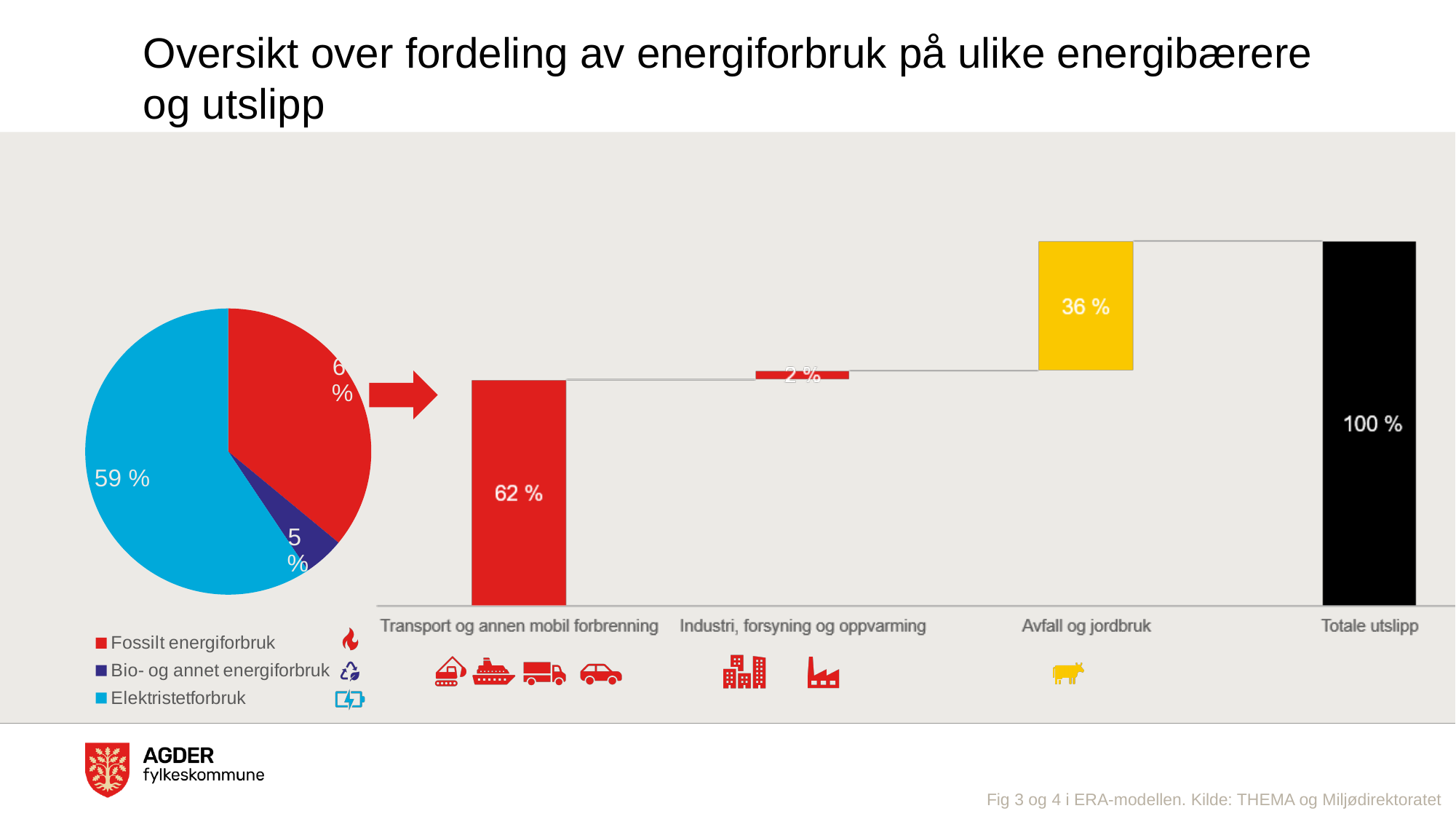
In the bar chart on the right, which category has the lowest value? Industri, forsyning og oppvarming In the bar chart on the right, what is the value for Transport og annen mobil forbrenning? 62 % How many categories are shown on the x axis of the bar chart on the right? 4 In the pie chart on the left, which category has the smallest slice? Bio- og annet energiforbruk In the pie chart on the left, which category has the largest slice? Elektristetforbruk What kind of chart is the chart on the left of the slide? Pie chart In the bar chart on the right, what is the value for Avfall og jordbruk? 36 % In the bar chart on the right, what is the difference between Transport og annen mobil forbrenning and Avfall og jordbruk? 26 % In the pie chart on the left, what is the value for Elektristetforbruk? 59 % How many categories does the legend of the pie chart on the left list? 3 In the bar chart on the right, what is the value for Industri, forsyning og oppvarming? 2 % In the pie chart on the left, what is the value for Bio- og annet energiforbruk? 5 %